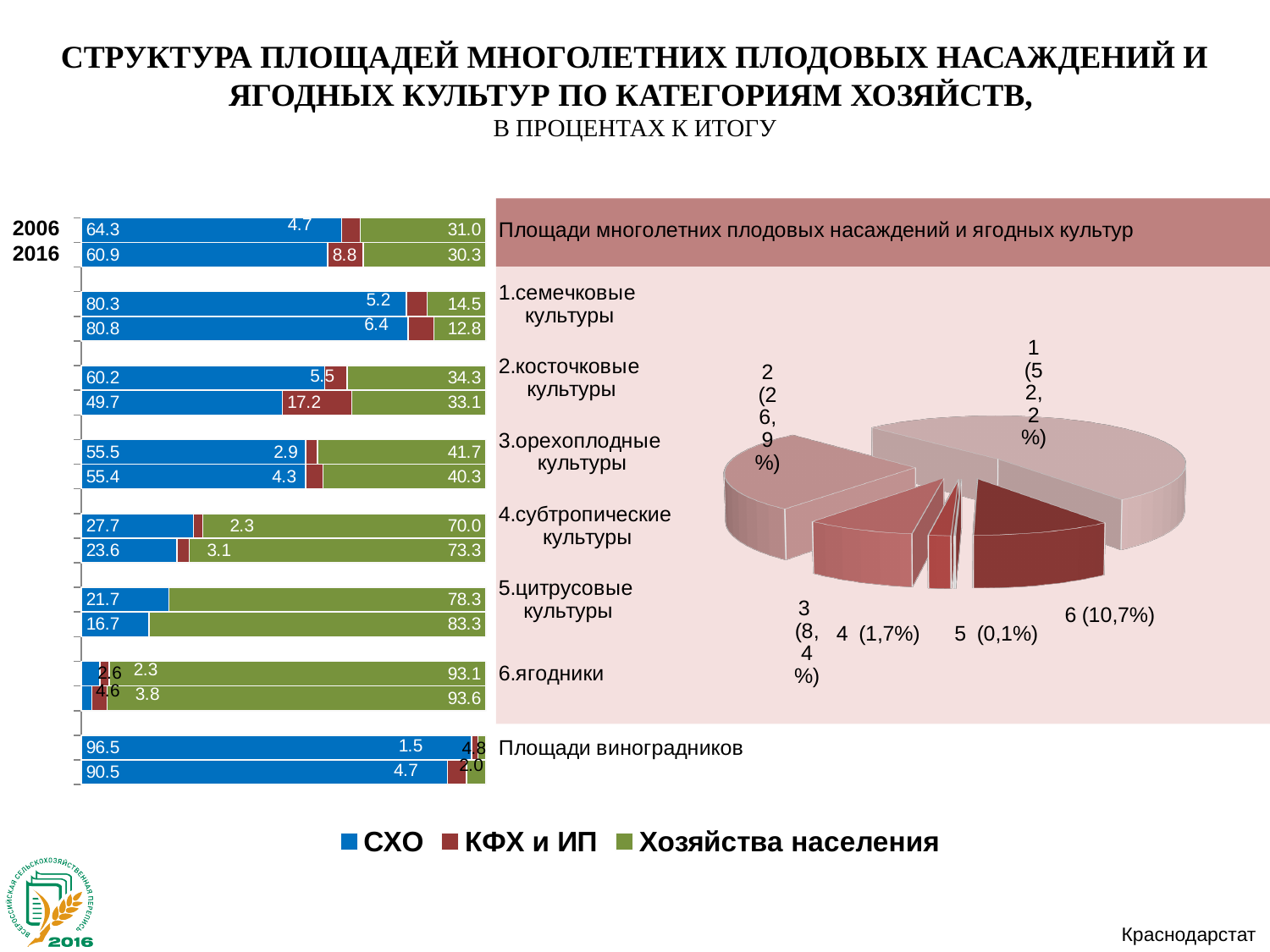
In the pie chart, which slice is the largest? 1 (52,2%) In the pie chart, which slice is the smallest? 5 (0,1%) In the pie chart, what share does slice 6 have? 10,7% How many series does the legend of the bar chart list? 3 What kind of chart is the chart on the left side of the slide? bar chart In the bar chart, what is the КФХ и ИП value for 2.косточковые культуры in 2016? 17.2 In the bar chart, did the СХО value for 2.косточковые культуры rise or fall from 2006 to 2016? fall In the bar chart, what is the СХО value for 1.семечковые культуры in 2016? 80.8 In the bar chart, what is the Хозяйства населения value for 4.субтропические культуры in 2016? 73.3 In the bar chart, by how much did the СХО value for 2.косточковые культуры change between 2006 and 2016? 10.5 In the bar chart, which has the larger Хозяйства населения value in 2016: 5.цитрусовые культуры or 4.субтропические культуры? 5.цитрусовые культуры In the bar chart, what is the СХО value for Площади многолетних плодовых насаждений и ягодных культур in 2006? 64.3